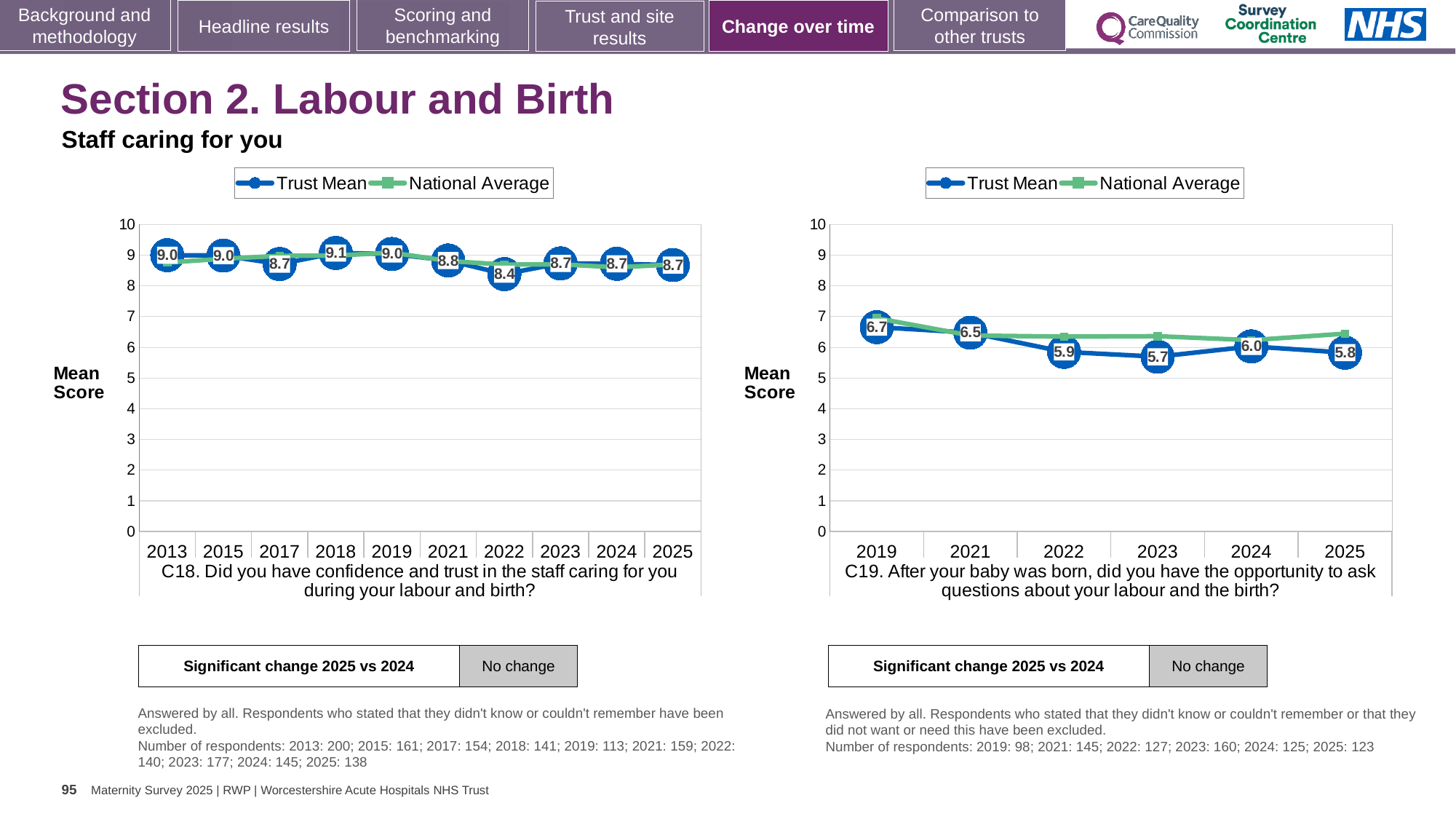
In the C18 chart on the left, what is the Trust Mean for 2018? 9.1 In the C18 chart on the left, what is the difference between the Trust Mean for 2018 and for 2022? 0.7 In the C19 chart on the right, is the Trust Mean for 2024 greater or less than the Trust Mean for 2023? greater What type of chart is the C19 chart on the right? Line chart In the C19 chart on the right, what is the Trust Mean for 2019? 6.7 How many series does the legend of the C19 chart on the right list? 2 How many years are plotted on the x axis of the C18 chart on the left? 10 In the C19 chart on the right, what is the Trust Mean for 2025? 5.8 In the C18 chart on the left, which year has the lowest Trust Mean? 2022 In the C18 chart on the left, what is the Trust Mean for 2022? 8.4 In the C18 chart on the left, which year has the highest Trust Mean? 2018 In the C19 chart on the right, which year has the lowest Trust Mean? 2023